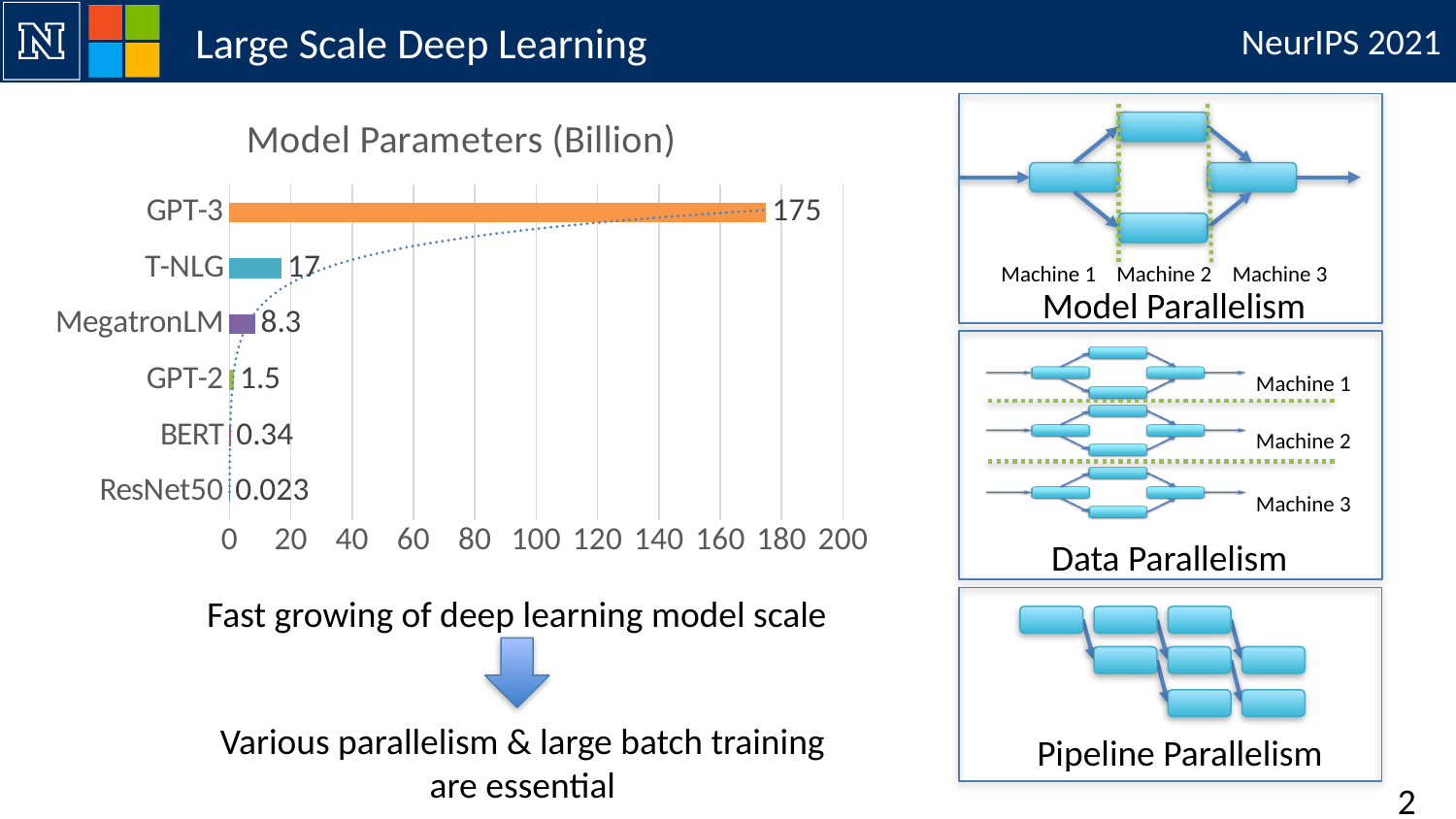
What kind of chart is used to show Model Parameters (Billion)? Bar chart What is the value for MegatronLM in the Model Parameters (Billion) chart? 8.3 How many models are shown in the Model Parameters (Billion) chart? 6 What is the value for GPT-3 in the Model Parameters (Billion) chart? 175 What is the value for T-NLG in the Model Parameters (Billion) chart? 17 Which has a larger value, MegatronLM or GPT-2? MegatronLM What is the value for ResNet50 in the Model Parameters (Billion) chart? 0.023 What is the title of the chart on the slide? Model Parameters (Billion) Which model has the lowest number of parameters in the chart? ResNet50 Which model has the highest number of parameters in the chart? GPT-3 What is the value for BERT in the Model Parameters (Billion) chart? 0.34 What is the difference between the values for GPT-3 and T-NLG? 158